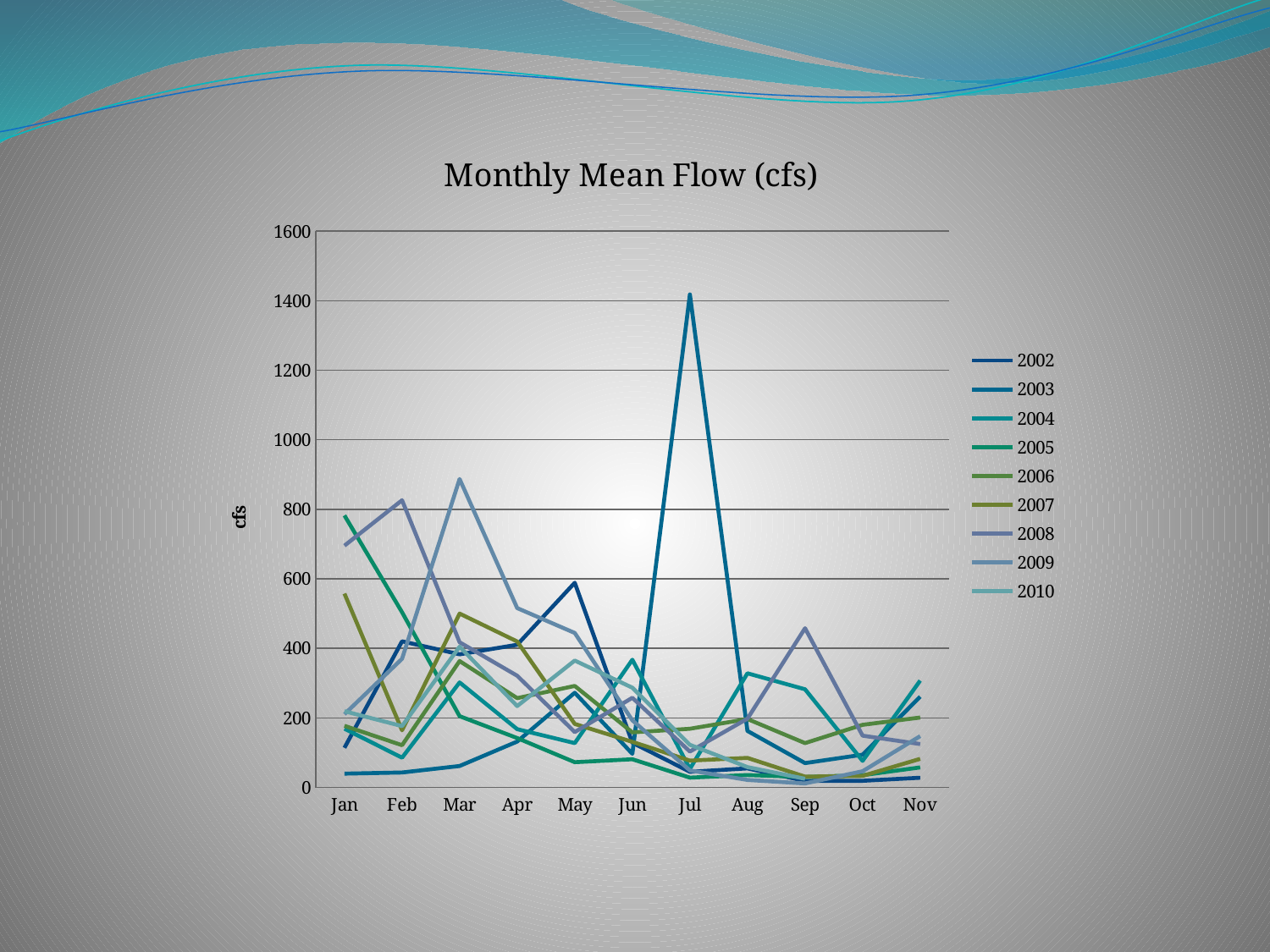
Is the value for 2003 in Jul greater or less than 1200? greater What kind of chart is shown on the slide? line chart How many months are shown along the x axis? 11 How many series does the legend list? 9 In which month does the 2003 series reach its highest value? Jul What is the label on the vertical axis? cfs Is the value for 2002 in May greater or less than 400? greater Is the value for 2005 in Jan greater or less than 600? greater What is the title of the chart? Monthly Mean Flow (cfs) Does the 2003 series rise or fall from Jul to Aug? fall Which series reaches the highest value anywhere on the chart? 2003